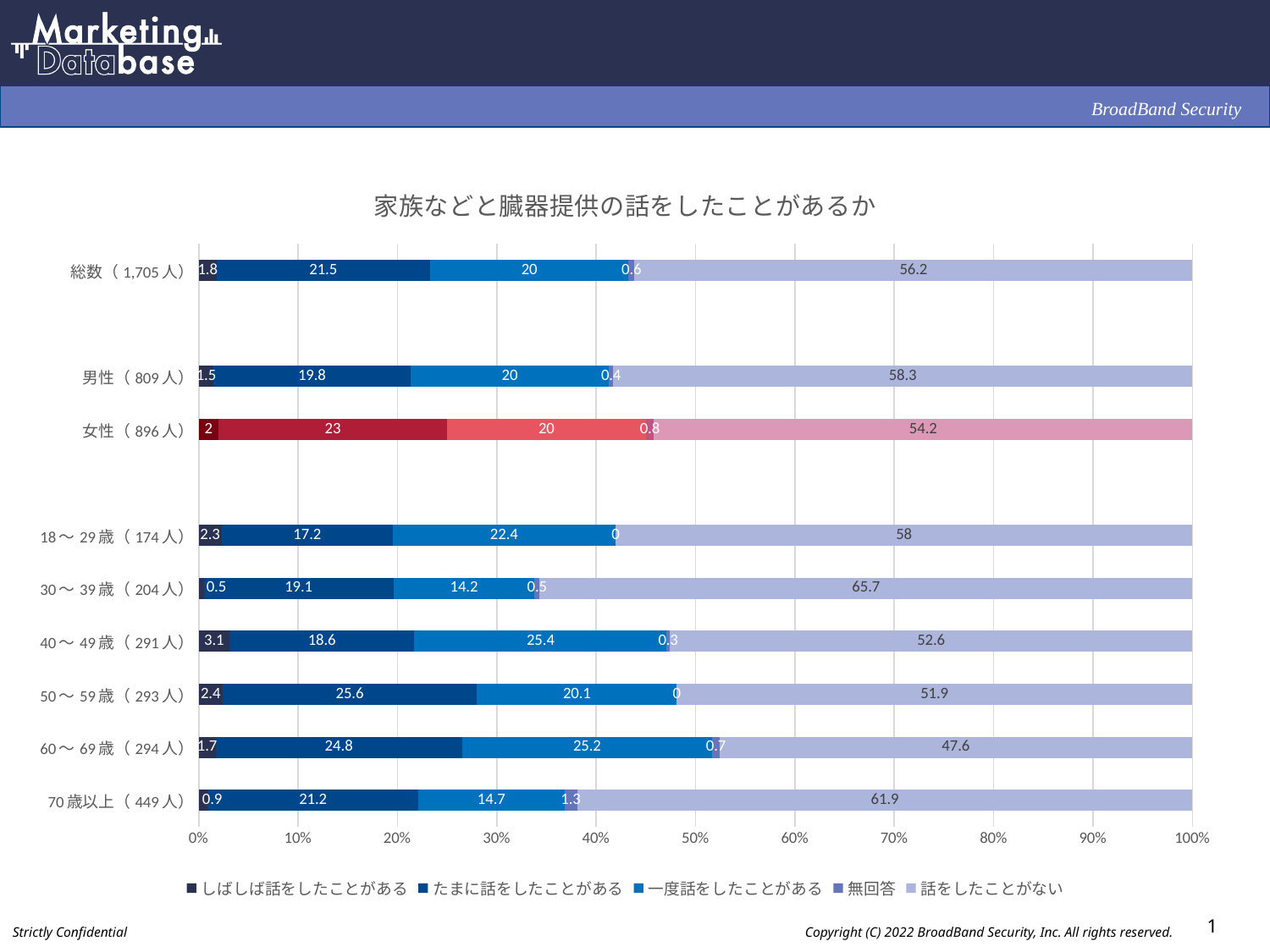
Which is larger, the 一度話をしたことがある value for 40～49歳 (291人) or for 70歳以上 (449人)? 40～49歳 (291人) What is the title of the chart? 家族などと臓器提供の話をしたことがあるか How many series does the legend list? 5 Which category has the highest value for 話をしたことがない? 30～39歳 (204人) How many categories are shown on the chart? 9 What is the difference between the 話をしたことがない values for 男性 (809人) and 女性 (896人)? 4.1 What is the value of 話をしたことがない for 総数 (1,705人)? 56.2 Which category has the lowest value for 話をしたことがない? 60～69歳 (294人) What is the total of the stacked bar for 女性 (896人)? 100 What is the value of しばしば話をしたことがある for 40～49歳 (291人)? 3.1 What kind of chart is shown on the slide? Stacked bar chart What is the value of たまに話をしたことがある for 50～59歳 (293人)? 25.6